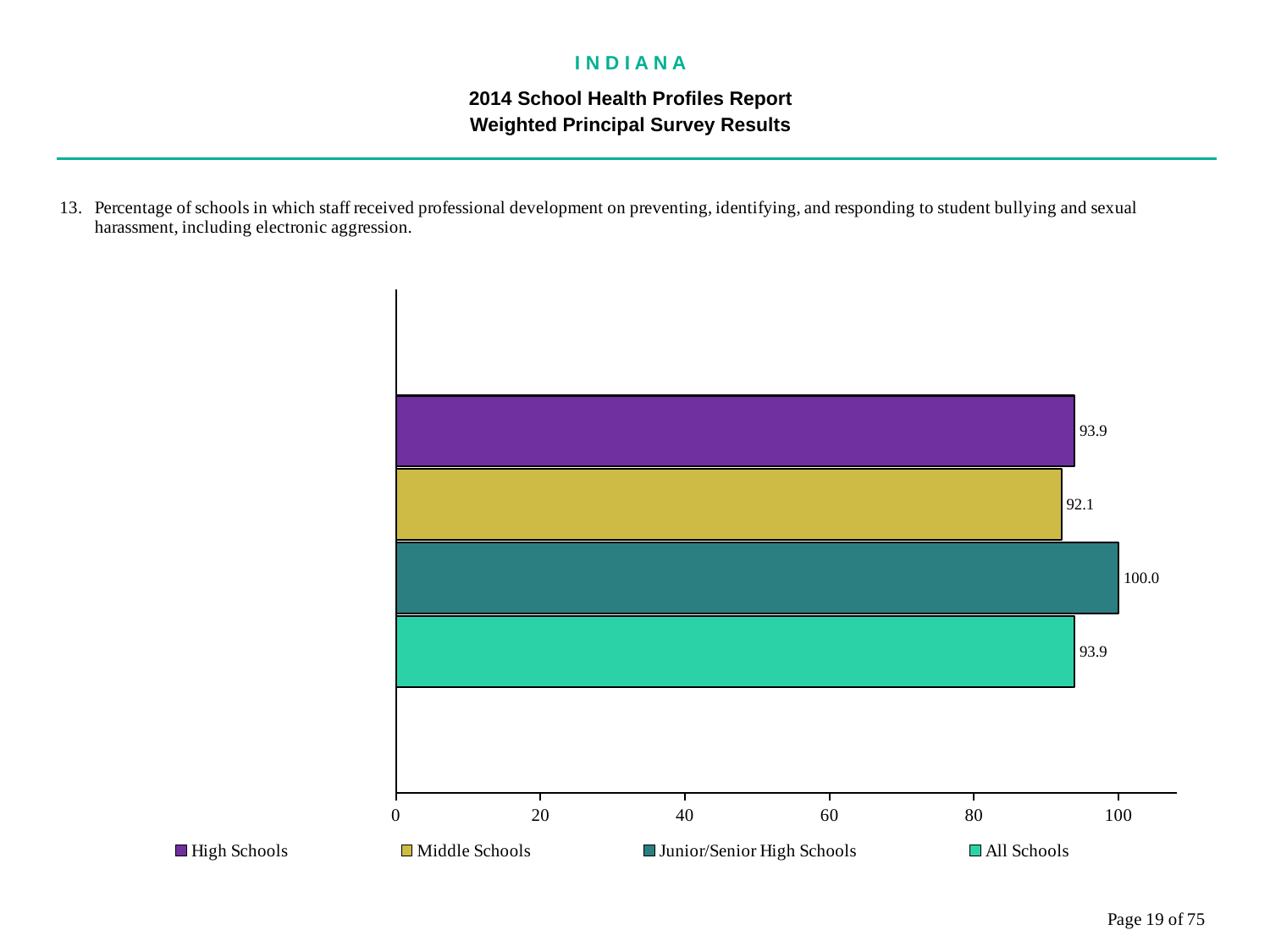
What is the value for High Schools? 93.9 How many bars are plotted in the chart? 4 Is the value for Middle Schools greater or less than 80? greater What is the difference between the values for High Schools and Middle Schools? 1.8 Which school type has the lowest value? Middle Schools Which school type has the highest value? Junior/Senior High Schools Which is larger, the value for Junior/Senior High Schools or the value for High Schools? Junior/Senior High Schools What is the value for All Schools? 93.9 What kind of chart is shown on the slide? bar chart What is the value for Middle Schools? 92.1 What is the value for Junior/Senior High Schools? 100.0 What is the difference between the values for Junior/Senior High Schools and Middle Schools? 7.9